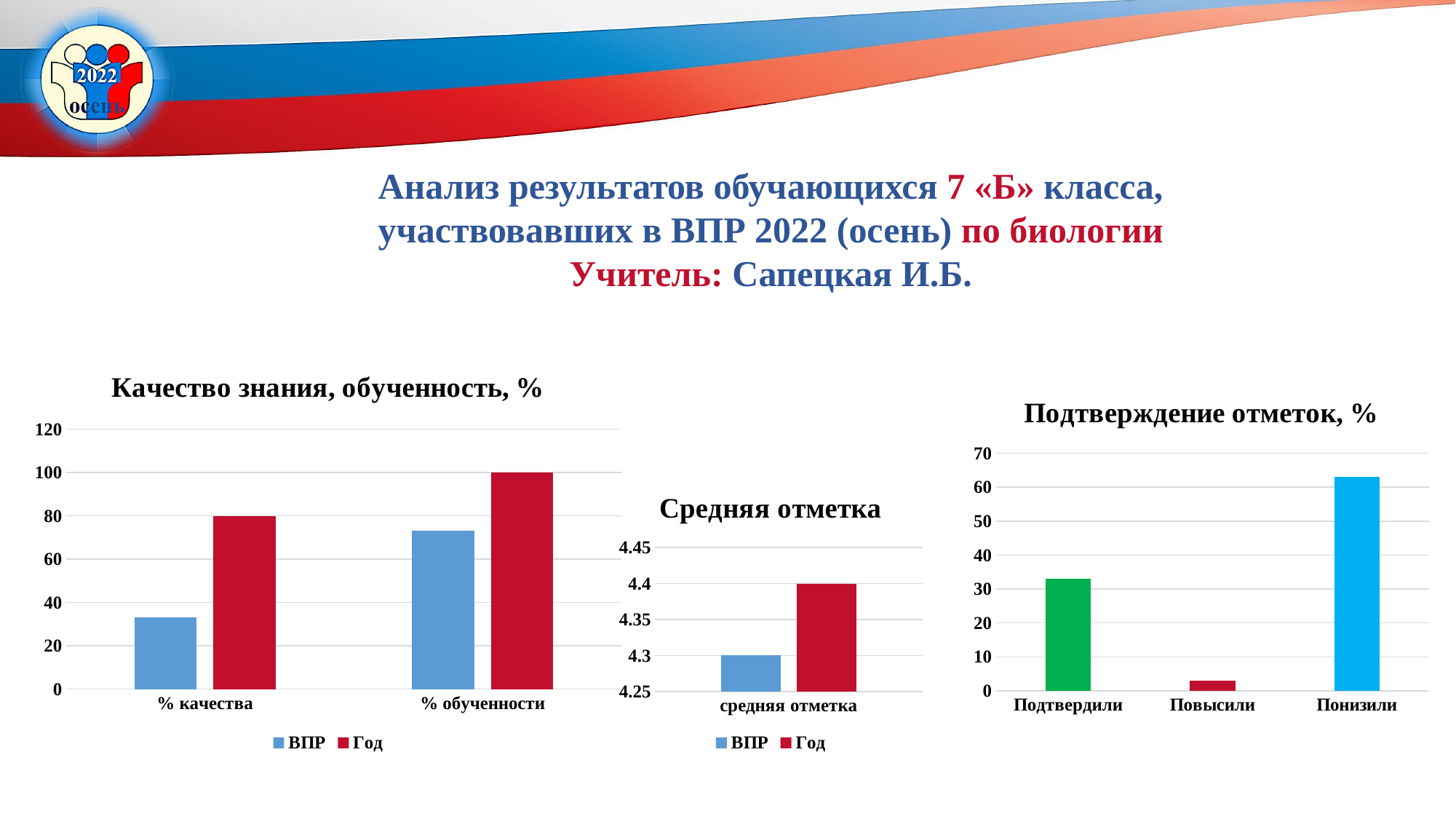
In the chart titled "Средняя отметка", what is the value for Год? 4.4 In the chart titled "Подтверждение отметок, %", which category has the lowest value? Повысили In the chart titled "Качество знания, обученность, %", is the ВПР value for % качества greater or less than 40? less In the chart titled "Средняя отметка", what is the difference between the Год and ВПР values? 0.1 In the chart titled "Качество знания, обученность, %", how many series does the legend list? 2 In the chart titled "Подтверждение отметок, %", is the value for Подтвердили greater or less than 30? greater In the chart titled "Подтверждение отметок, %", which category has the highest value? Понизили In the chart titled "Качество знания, обученность, %", what is the value of Год for % качества? 80 In the chart titled "Качество знания, обученность, %", what is the value of Год for % обученности? 100 What type of chart is the chart titled "Подтверждение отметок, %"? bar chart In the chart titled "Качество знания, обученность, %", is the ВПР value for % обученности greater or less than 60? greater In the chart titled "Средняя отметка", what is the value for ВПР? 4.3